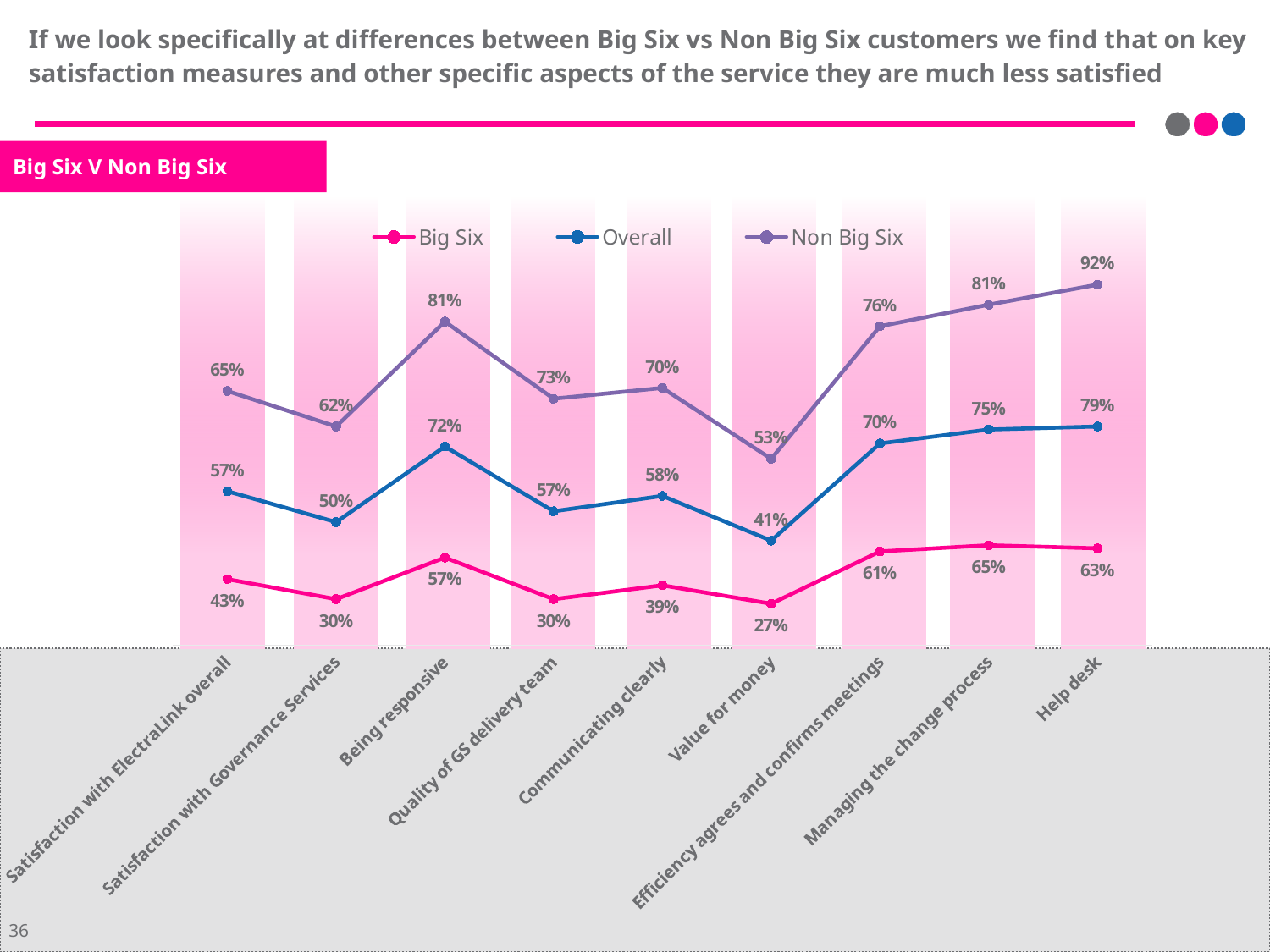
What is the difference between the Non Big Six and Big Six values for Quality of GS delivery team? 43% What is the title shown in the pink box above the chart? Big Six V Non Big Six Which category has the highest Overall value? Help desk How many series does the legend list? 3 Which is larger for Managing the change process: the Overall value or the Big Six value? Overall What type of chart is shown on the slide? Line chart What is the Non Big Six value for Help desk? 92% Which category has the highest Non Big Six value? Help desk What is the Overall value for Being responsive? 72% Which category has the lowest Big Six value? Value for money How many categories are plotted along the x axis? 9 What is the Big Six value for Value for money? 27%